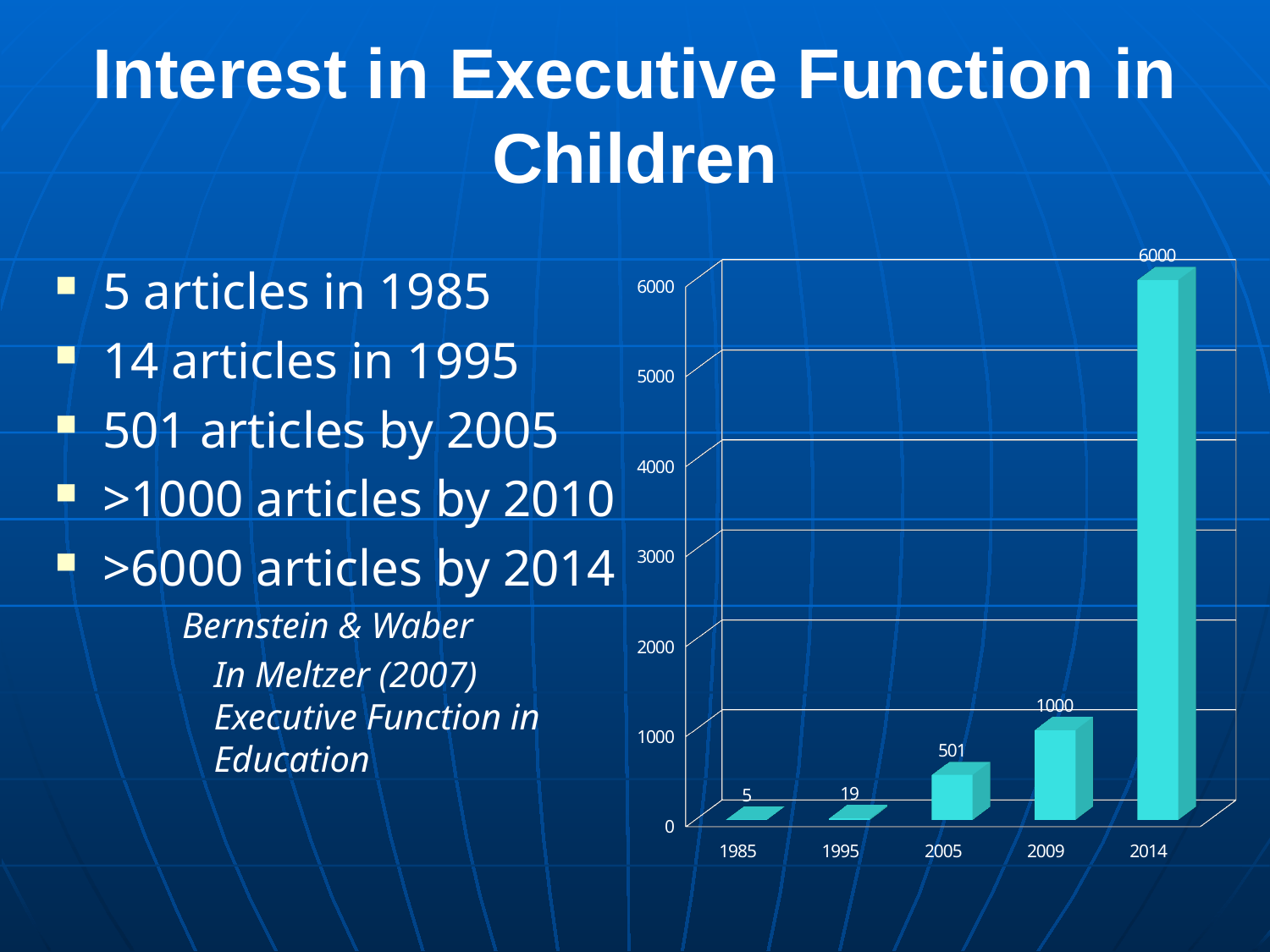
Which is larger, the value for 2005 or the value for 1995? 2005 What value is shown for 1995 in the chart? 19 How many years are shown on the x axis of the chart? 5 What is the difference between the values for 2014 and 2009? 5000 What is the difference between the values for 2009 and 2005? 499 What value is shown for 2005 in the chart? 501 Is the value for 2009 greater or less than 2000? less Which year has the lowest value in the chart? 1985 What value is shown for 2014 in the chart? 6000 Which year has the highest value in the chart? 2014 Do the values rise or fall from 1985 to 2014? rise What kind of chart is shown on the slide? bar chart